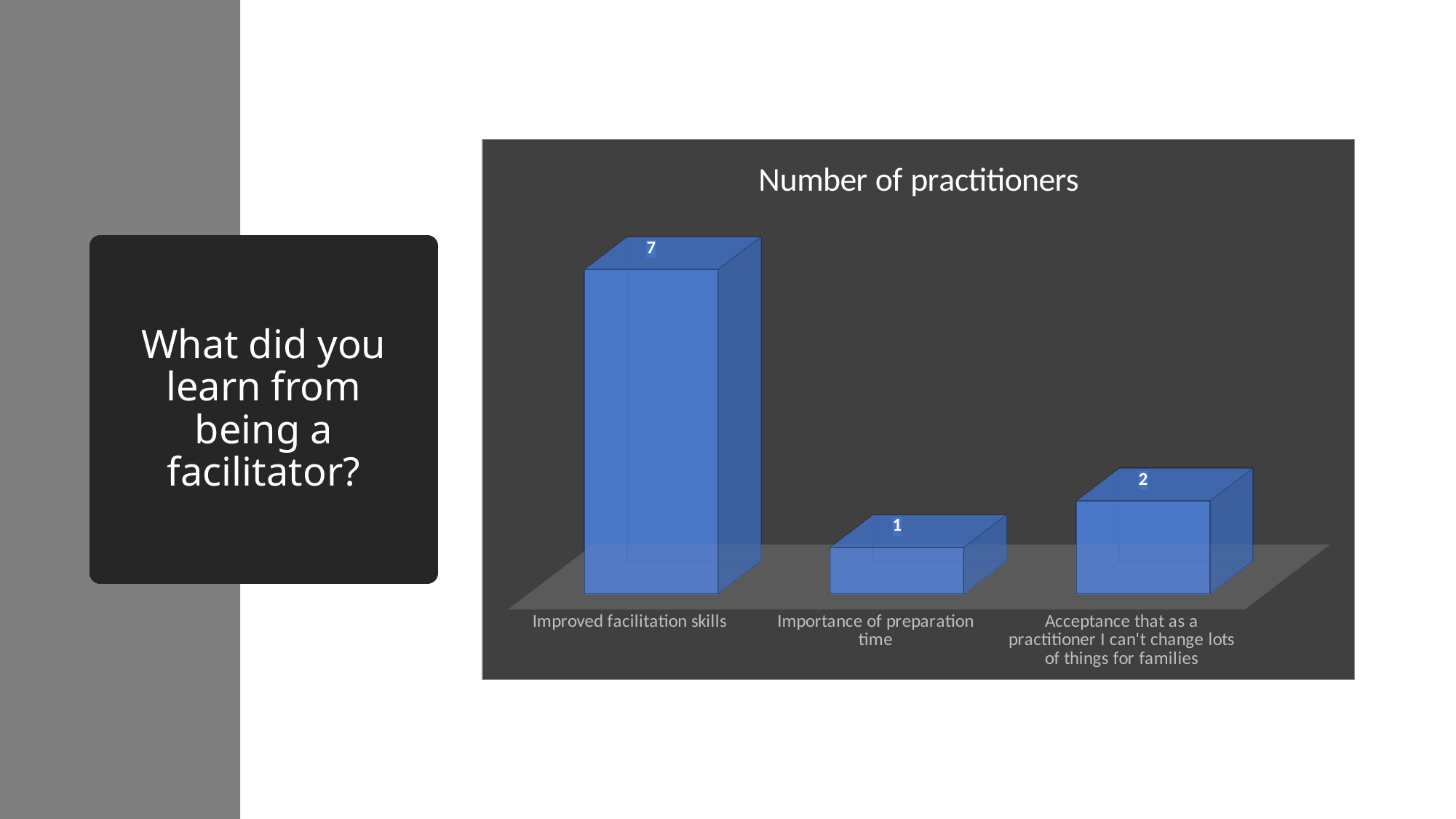
What is the title of the chart? Number of practitioners What is the value for Acceptance that as a practitioner I can't change lots of things for families? 2 What is the difference between the values for Acceptance that as a practitioner I can't change lots of things for families and Importance of preparation time? 1 Which category has the highest value? Improved facilitation skills How many categories are shown in the chart? 3 What kind of chart is shown on the slide? Bar chart What is the value for Importance of preparation time? 1 What is the value for Improved facilitation skills? 7 Which is larger: the value for Improved facilitation skills or the value for Acceptance that as a practitioner I can't change lots of things for families? Improved facilitation skills Which category has the lowest value? Importance of preparation time What is the total of all the values shown in the chart? 10 What is the difference between the values for Improved facilitation skills and Importance of preparation time? 6